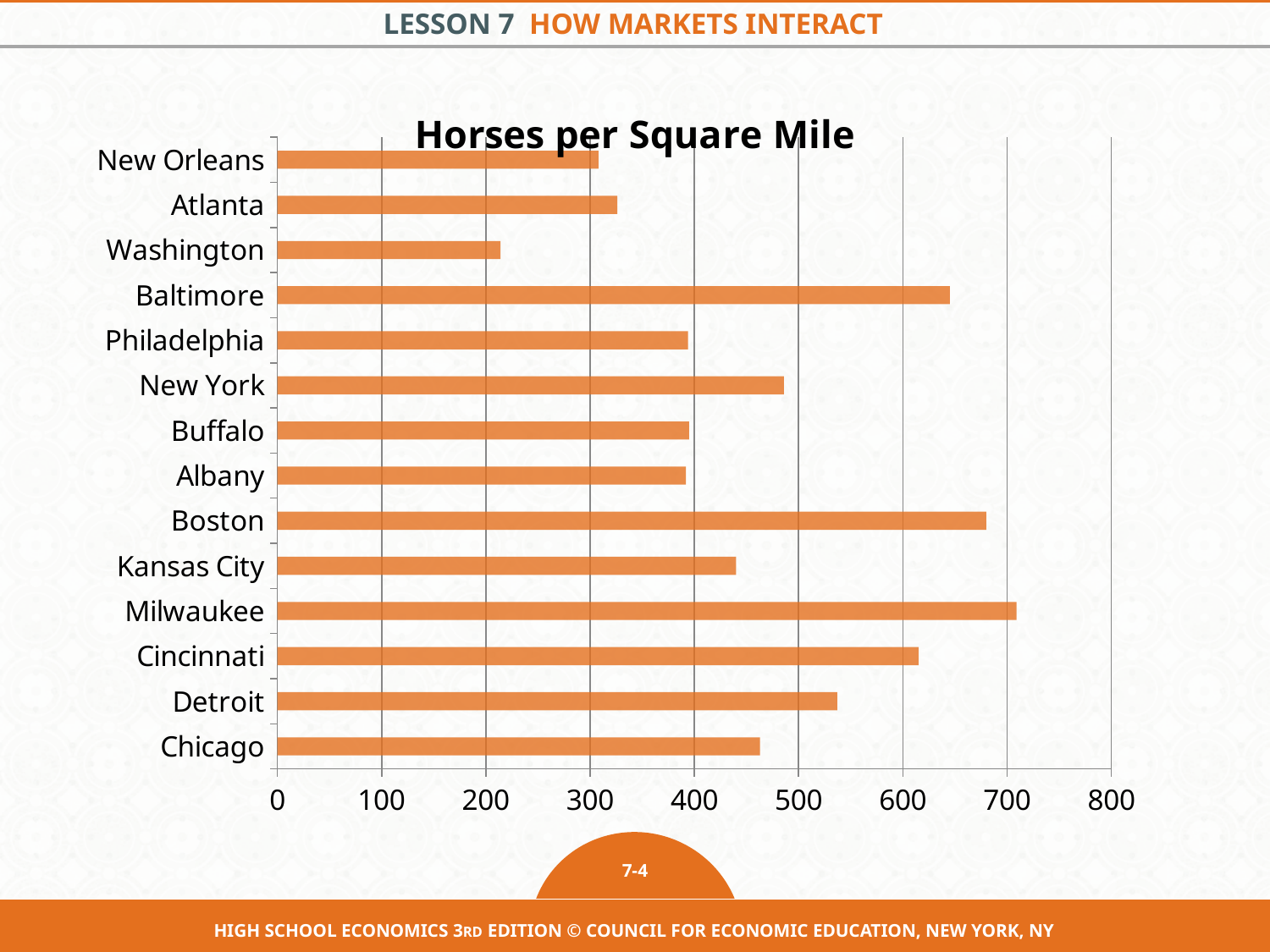
Is the value for Baltimore greater or less than 600? greater Which has more horses per square mile, New York or Atlanta? New York Is the value for Detroit greater or less than 500? greater Which city has the highest number of horses per square mile? Milwaukee What kind of chart is shown on the slide? bar chart Is the value for Chicago greater or less than 500? less How many cities are shown in the chart? 14 What is the title of the chart? Horses per Square Mile Which city has the lowest number of horses per square mile? Washington Which has more horses per square mile, Boston or Detroit? Boston